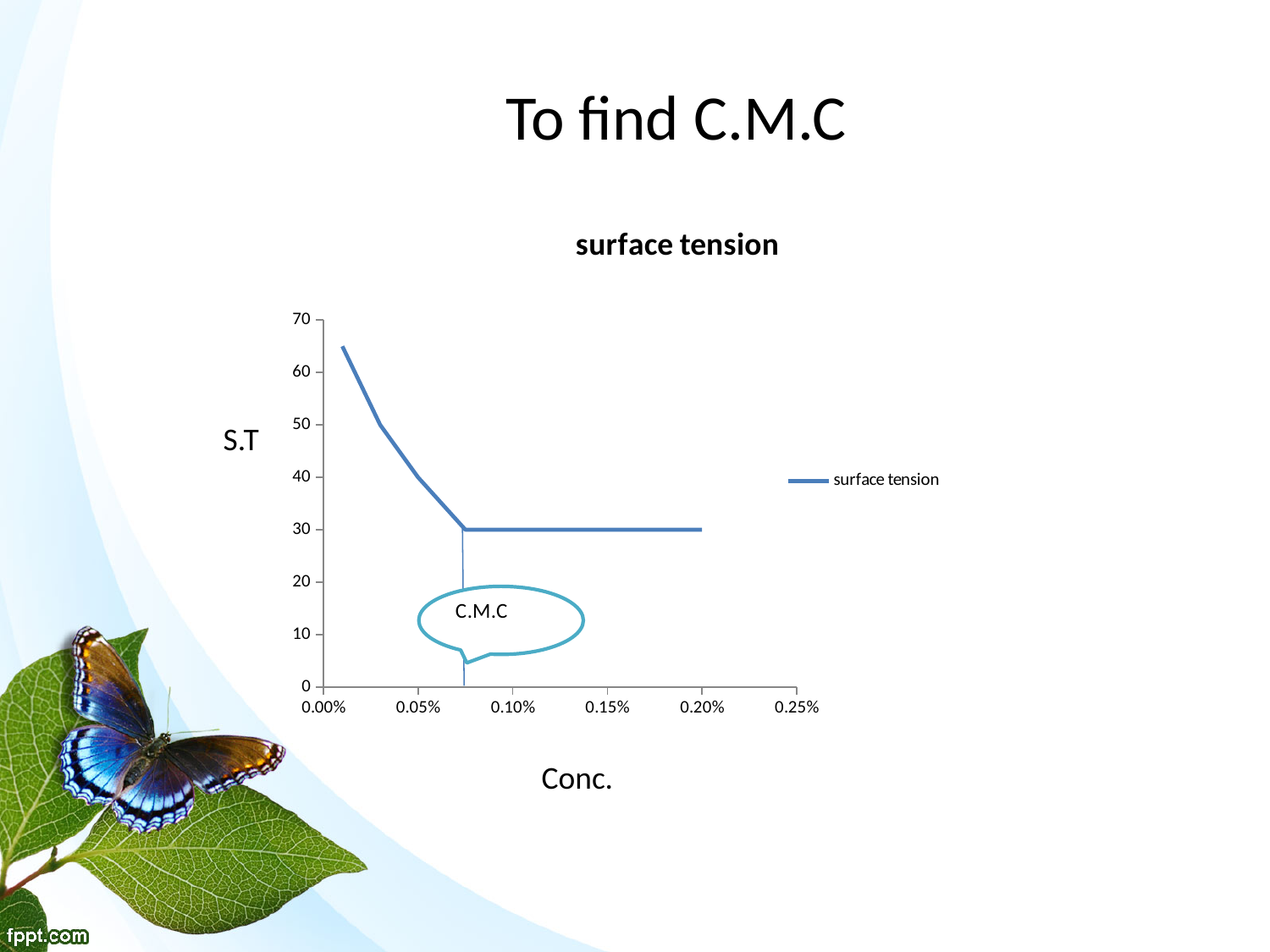
Is the surface tension value at 0.05% concentration greater or less than 50? less Does the surface tension rise, fall or stay flat between 0.10% and 0.20% concentration? stay flat Is the surface tension value at 0.10% concentration greater or less than 40? less How many series does the legend list? 1 What kind of chart is shown on the slide? line chart Is the surface tension value at 0.15% concentration greater or less than 40? less What is the surface tension value at 0.20% concentration? 30 What is the name of the series shown in the legend? surface tension Does the surface tension rise or fall as concentration increases from 0.00% to 0.05%? fall What is the title of the chart? surface tension Is the surface tension at 0.05% concentration larger or smaller than at 0.15% concentration? larger